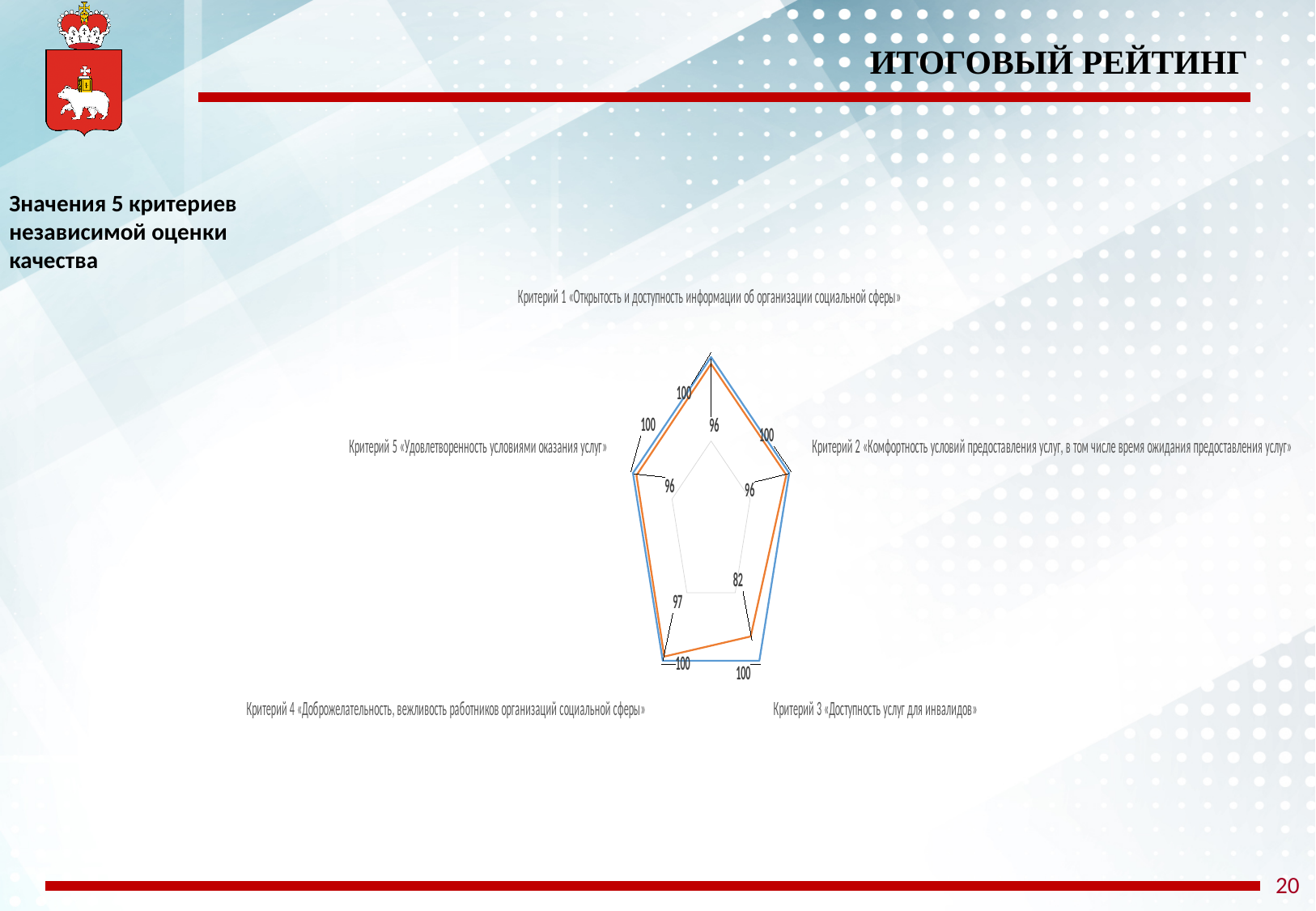
Which series has the larger value for Критерий 5 «Удовлетворенность условиями оказания услуг», blue or orange? blue What is the value of the orange series for Критерий 1 «Открытость и доступность информации об организации социальной сферы»? 96 How many criteria (axes) does the radar chart have? 5 What is the value of the orange series for Критерий 3 «Доступность услуг для инвалидов»? 82 For which criterion does the orange series have its lowest value? Критерий 3 «Доступность услуг для инвалидов» What is the value of the orange series for Критерий 4 «Доброжелательность, вежливость работников организаций социальной сферы»? 97 What value does the blue series have on every criterion? 100 What is the difference between the blue and orange series values for Критерий 4? 3 What kind of chart is shown on the slide? radar chart What is the value of the blue series for Критерий 2 «Комфортность условий предоставления услуг»? 100 What is the difference between the blue and orange series values for Критерий 3 «Доступность услуг для инвалидов»? 18 For which criterion does the orange series have its highest value? Критерий 4 «Доброжелательность, вежливость работников организаций социальной сферы»